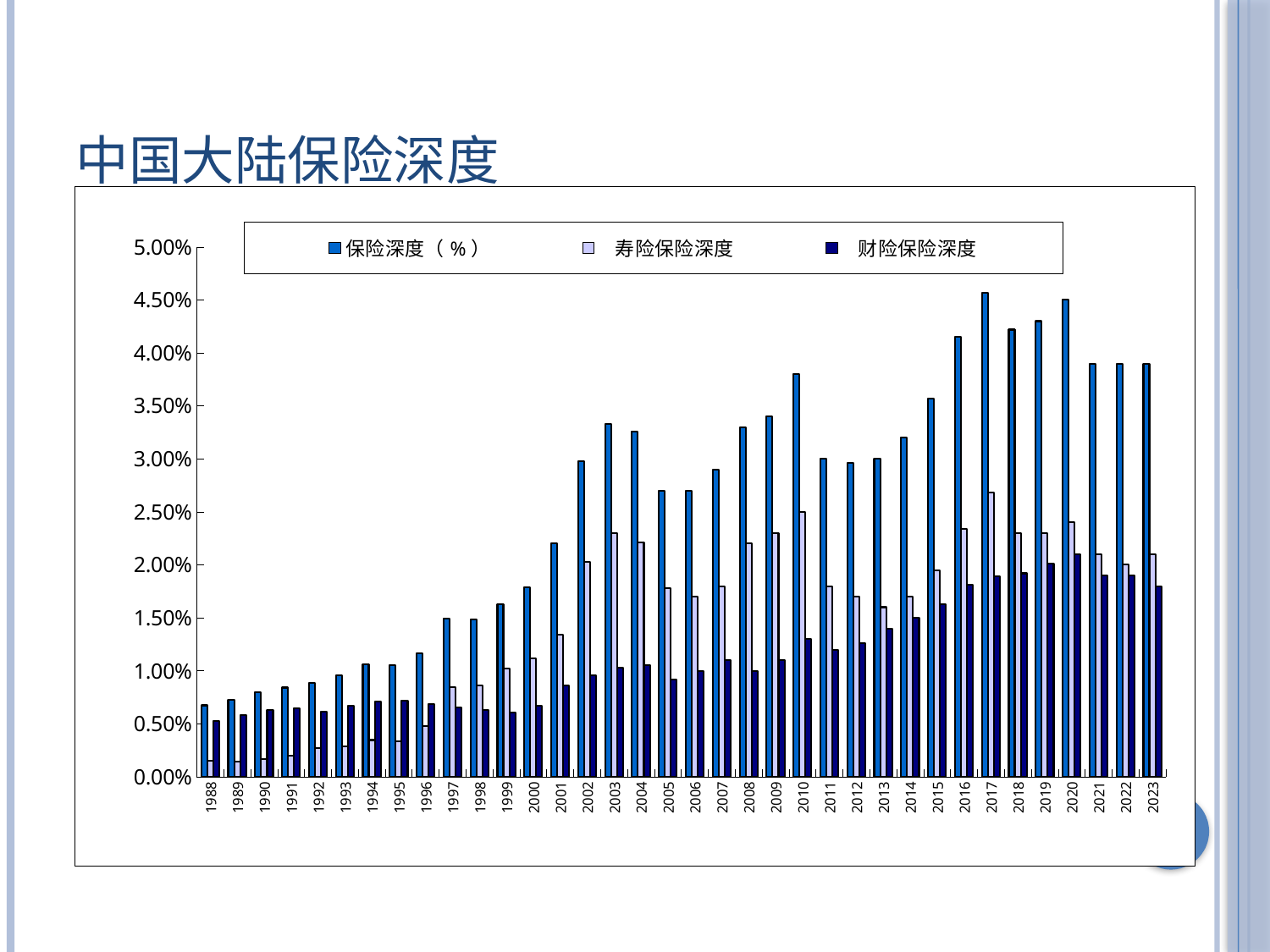
Which year has the larger 保险深度（%） value, 2010 or 2011? 2010 What is the title of the slide? 中国大陆保险深度 In which year is 寿险保险深度 highest? 2017 Is the value of 保险深度（%） for 2010 greater or less than 3.50%? greater How many series does the legend list? 3 Which series is shown with the lightest-coloured bars? 寿险保险深度 Is the value of 保险深度（%） for 1988 greater or less than 1.00%? less How many years are shown on the x axis? 36 In which year is 保险深度（%） highest? 2017 Is the value of 寿险保险深度 for 2020 greater or less than 2.00%? greater What kind of chart is shown on the slide? bar chart